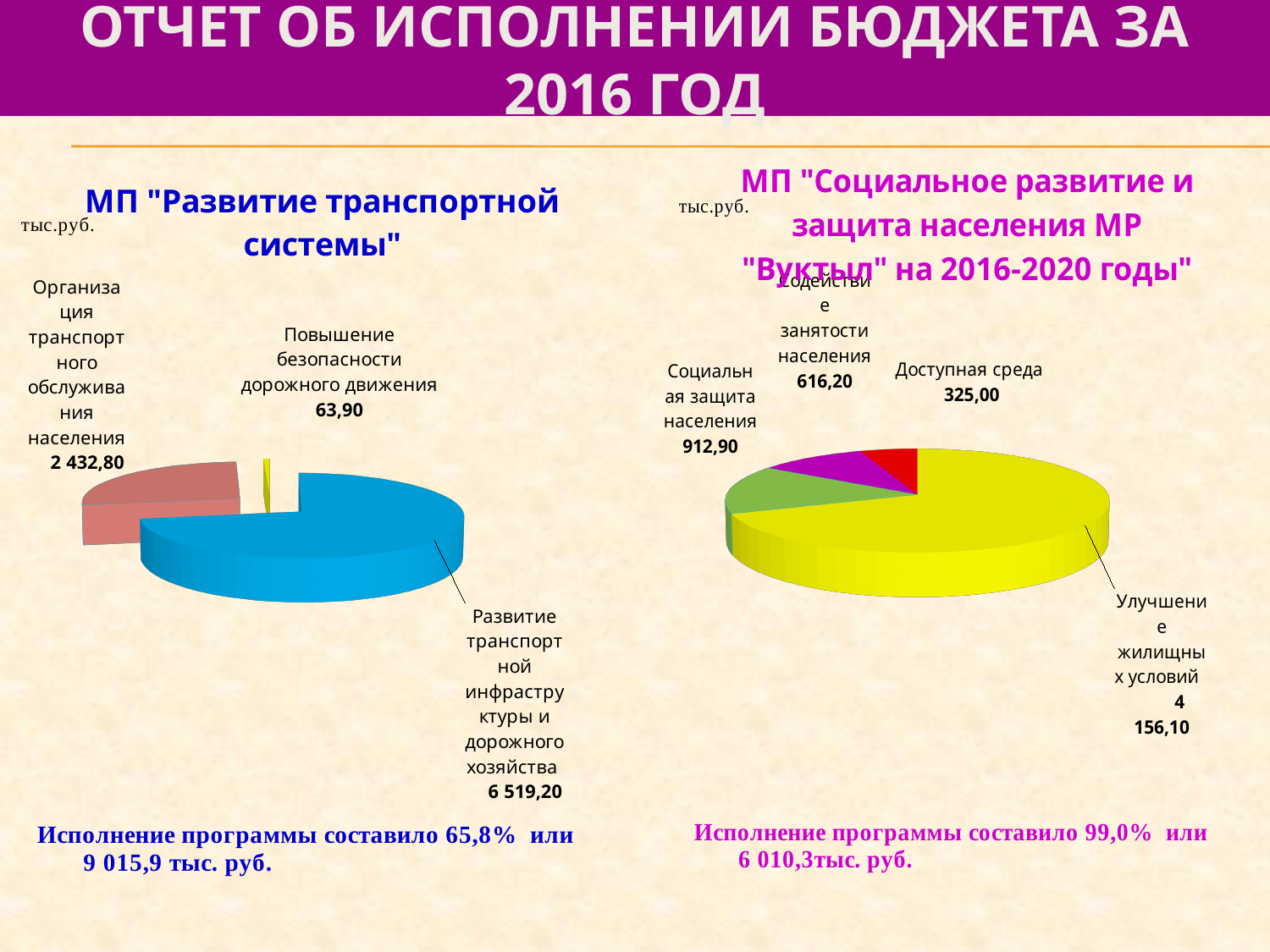
In the chart МП "Социальное развитие и защита населения МР "Вуктыл" на 2016-2020 годы", what is the value for Доступная среда? 325,00 In the chart МП "Социальное развитие и защита населения МР "Вуктыл" на 2016-2020 годы", what is the difference between Социальная защита населения and Содействие занятости населения? 296,70 In the chart МП "Развитие транспортной системы", what is the difference between Развитие транспортной инфраструктуры и дорожного хозяйства and Организация транспортного обслуживания населения? 4 086,40 What type of chart is used for МП "Развитие транспортной системы"? Pie chart In the chart МП "Социальное развитие и защита населения МР "Вуктыл" на 2016-2020 годы", which category has the largest value? Улучшение жилищных условий In the chart МП "Развитие транспортной системы", which category has the smallest value? Повышение безопасности дорожного движения How many categories are shown in the chart МП "Социальное развитие и защита населения МР "Вуктыл" на 2016-2020 годы"? 4 How many slices does the chart МП "Развитие транспортной системы" have? 3 In the chart МП "Развитие транспортной системы", what is the value for Повышение безопасности дорожного движения? 63,90 In the chart МП "Развитие транспортной системы", what is the value for Развитие транспортной инфраструктуры и дорожного хозяйства? 6 519,20 In the chart МП "Социальное развитие и защита населения МР "Вуктыл" на 2016-2020 годы", which is larger: Социальная защита населения or Содействие занятости населения? Социальная защита населения What unit is indicated for the values in both charts on the slide? тыс.руб.